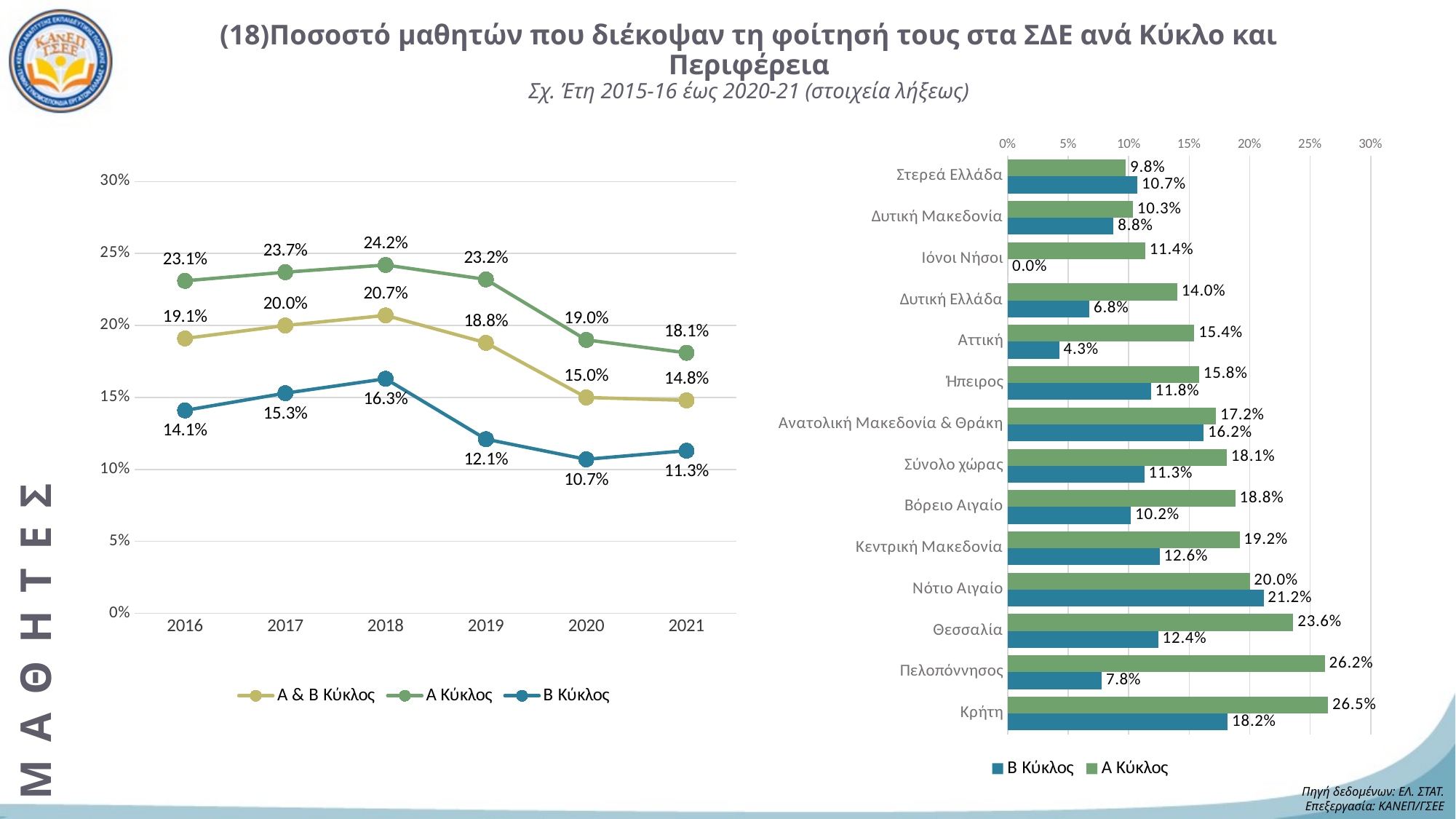
In the line chart on the left, what is the value for Α Κύκλος in 2018? 24.2% In the line chart on the left, what is the value for Β Κύκλος in 2020? 10.7% In the line chart on the left, does the Α Κύκλος series rise or fall from 2018 to 2021? fall In the bar chart on the right, which region has the lowest Β Κύκλος value? Ιόνοι Νήσοι In the line chart on the left, how many series does the legend list? 3 In the line chart on the left, what is the difference between Α Κύκλος and Β Κύκλος in 2021? 6.8% What kind of chart is shown on the right side of the slide? bar chart In the bar chart on the right, which is larger for Νότιο Αιγαίο, the Α Κύκλος value or the Β Κύκλος value? Β Κύκλος In the line chart on the left, in which year is the Β Κύκλος series lowest? 2020 In the bar chart on the right, which region has the highest Α Κύκλος value? Κρήτη In the line chart on the left, in which year is the Α & Β Κύκλος series highest? 2018 In the bar chart on the right, what is the Α Κύκλος value for Θεσσαλία? 23.6%